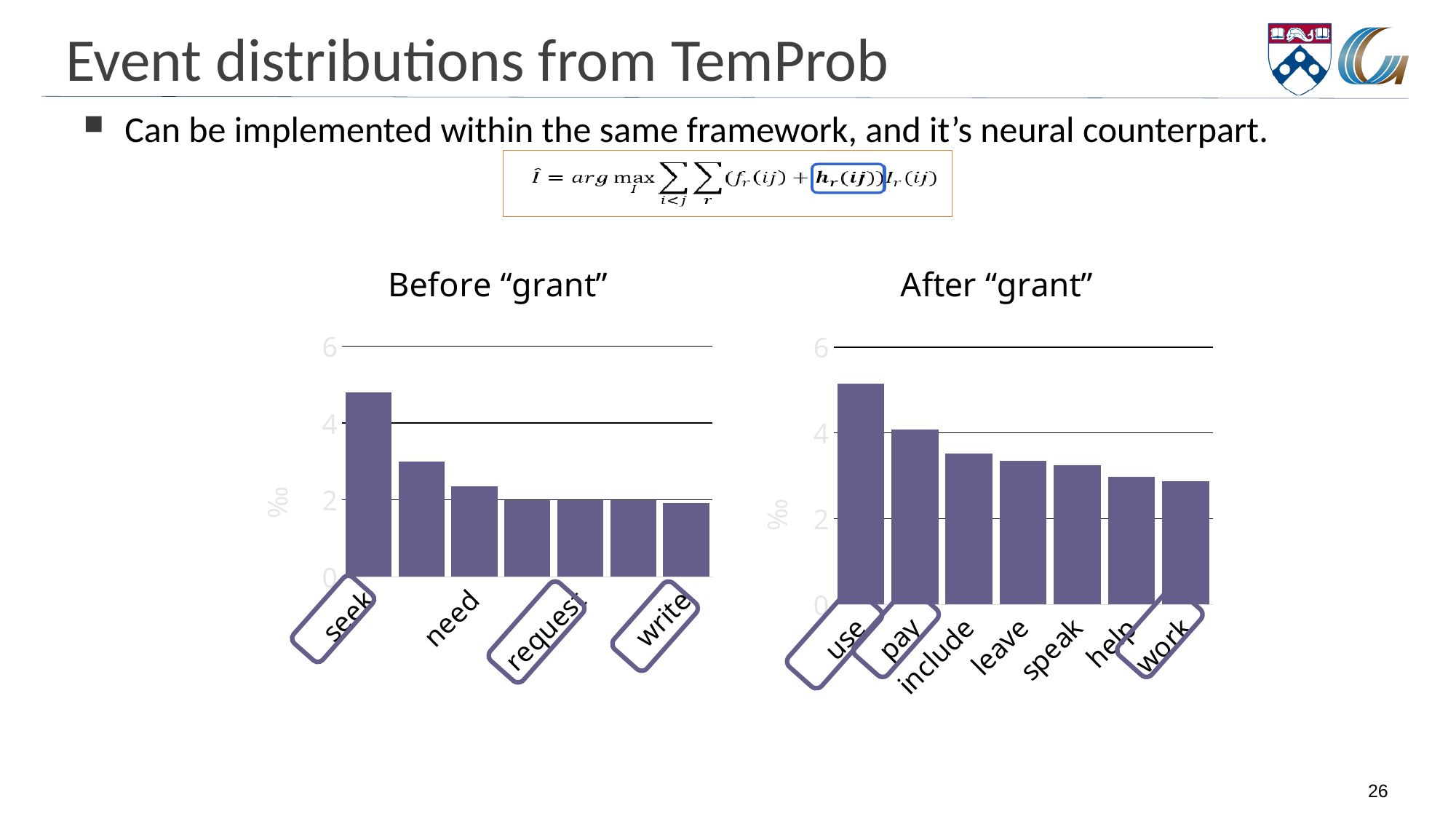
How many bars does the "After "grant"" chart have? 7 How many bars does the "Before "grant"" chart have? 7 What is the y-axis label on the "After "grant"" chart? ‰ In the "After "grant"" chart, which is larger, the value for pay or the value for include? pay In the "After "grant"" chart, which category has the highest value? use In the "After "grant"" chart, which category has the lowest value? work What kind of chart is the "Before "grant"" chart? bar chart In the "Before "grant"" chart, which category has the highest value? seek In the "Before "grant"" chart, is the value for seek greater or less than 4? greater In the "After "grant"" chart, is the value for help greater or less than 4? less In the "After "grant"" chart, do the values rise or fall from left to right? fall In the "After "grant"" chart, is the value for use greater or less than 4? greater